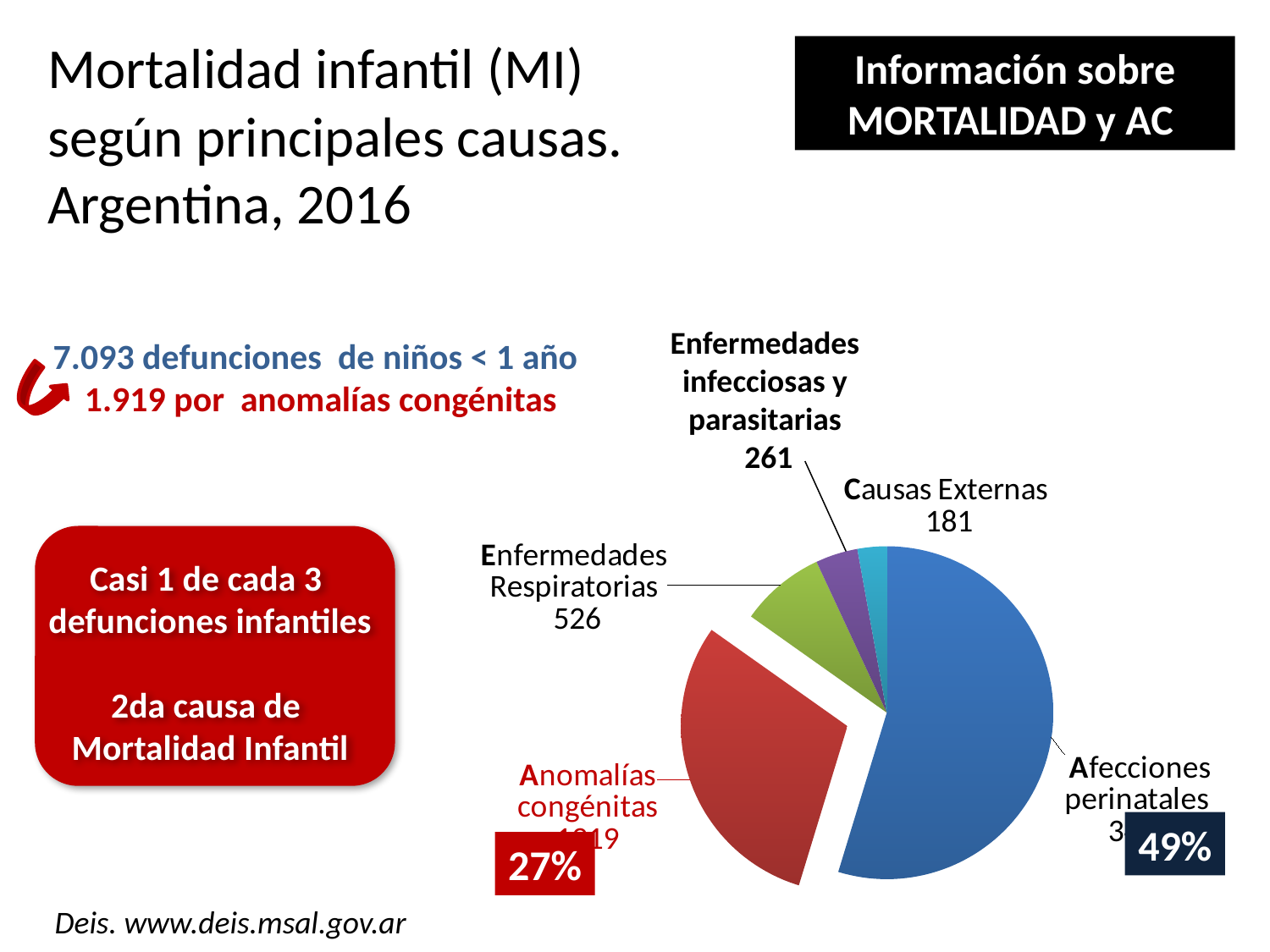
How many causes (slices) does the pie chart show? 5 What is the value for Enfermedades Respiratorias in the pie chart? 526 What is the difference between the values for Enfermedades infecciosas y parasitarias and Causas Externas? 80 What is the difference between the values for Enfermedades Respiratorias and Enfermedades infecciosas y parasitarias? 265 Which cause has the smallest slice in the pie chart? Causas Externas What share of the pie does Anomalías congénitas represent, according to the percentage shown on the slide? 27% Which cause has the largest slice in the pie chart? Afecciones perinatales What is the value for Enfermedades infecciosas y parasitarias in the pie chart? 261 What is the value for Causas Externas in the pie chart? 181 Which is larger: Enfermedades Respiratorias or Causas Externas? Enfermedades Respiratorias What type of chart is shown on the slide? pie chart What share of the pie does Afecciones perinatales represent, according to the percentage shown on the slide? 49%